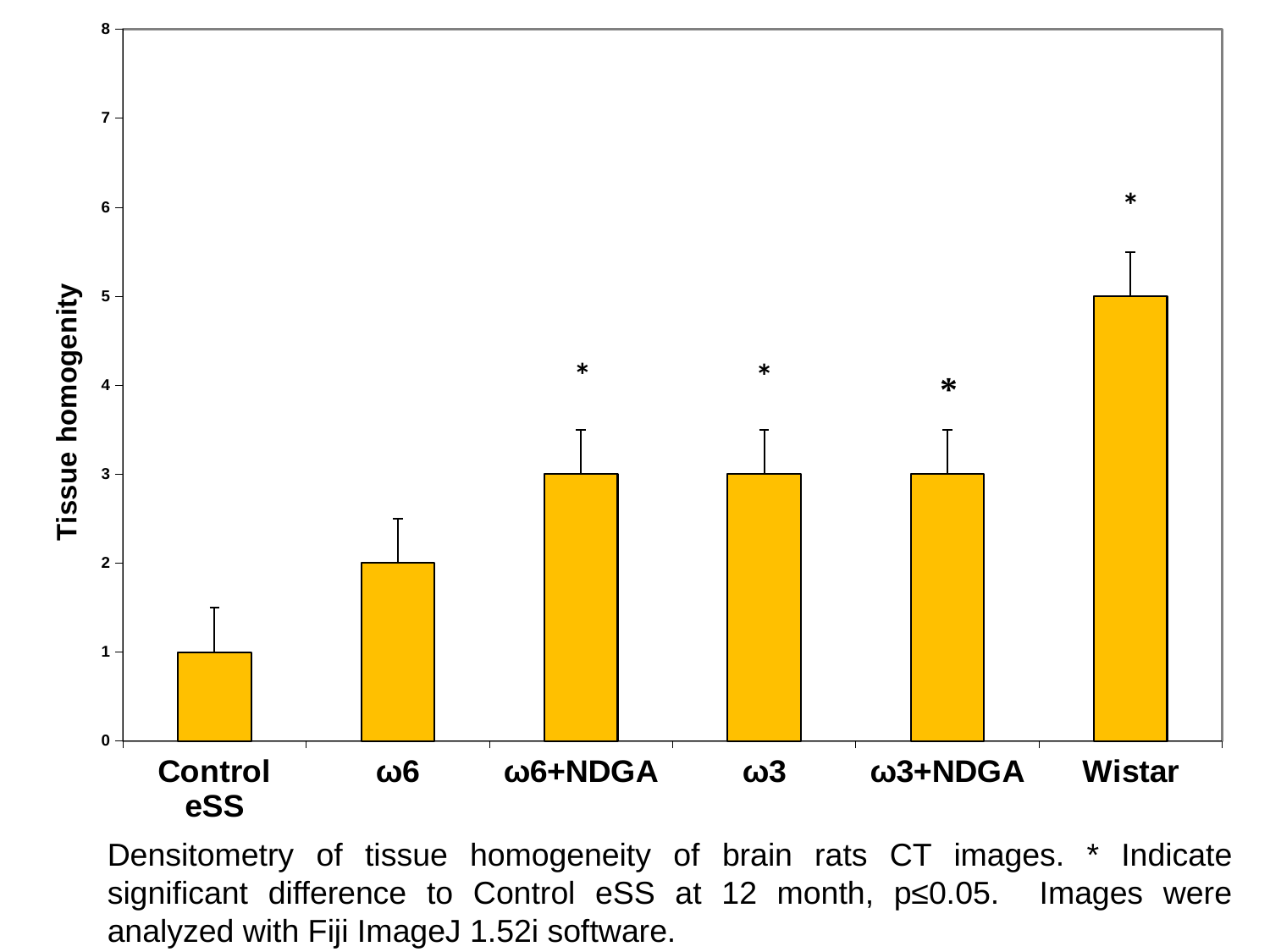
What is the difference between the Wistar value and the Control eSS value? 4 Is the value for Wistar greater or less than 4? greater What is the label of the y axis? Tissue homogenity What is the tissue homogeneity value for Wistar? 5 What is the tissue homogeneity value for ω6? 2 Which category has the lowest tissue homogeneity? Control eSS Which is larger, the value for ω6 or the value for ω3? ω3 What is the tissue homogeneity value for ω3+NDGA? 3 What is the tissue homogeneity value for Control eSS? 1 Which category has the highest tissue homogeneity? Wistar How many categories are plotted on the x axis? 6 What kind of chart is shown on the slide? bar chart